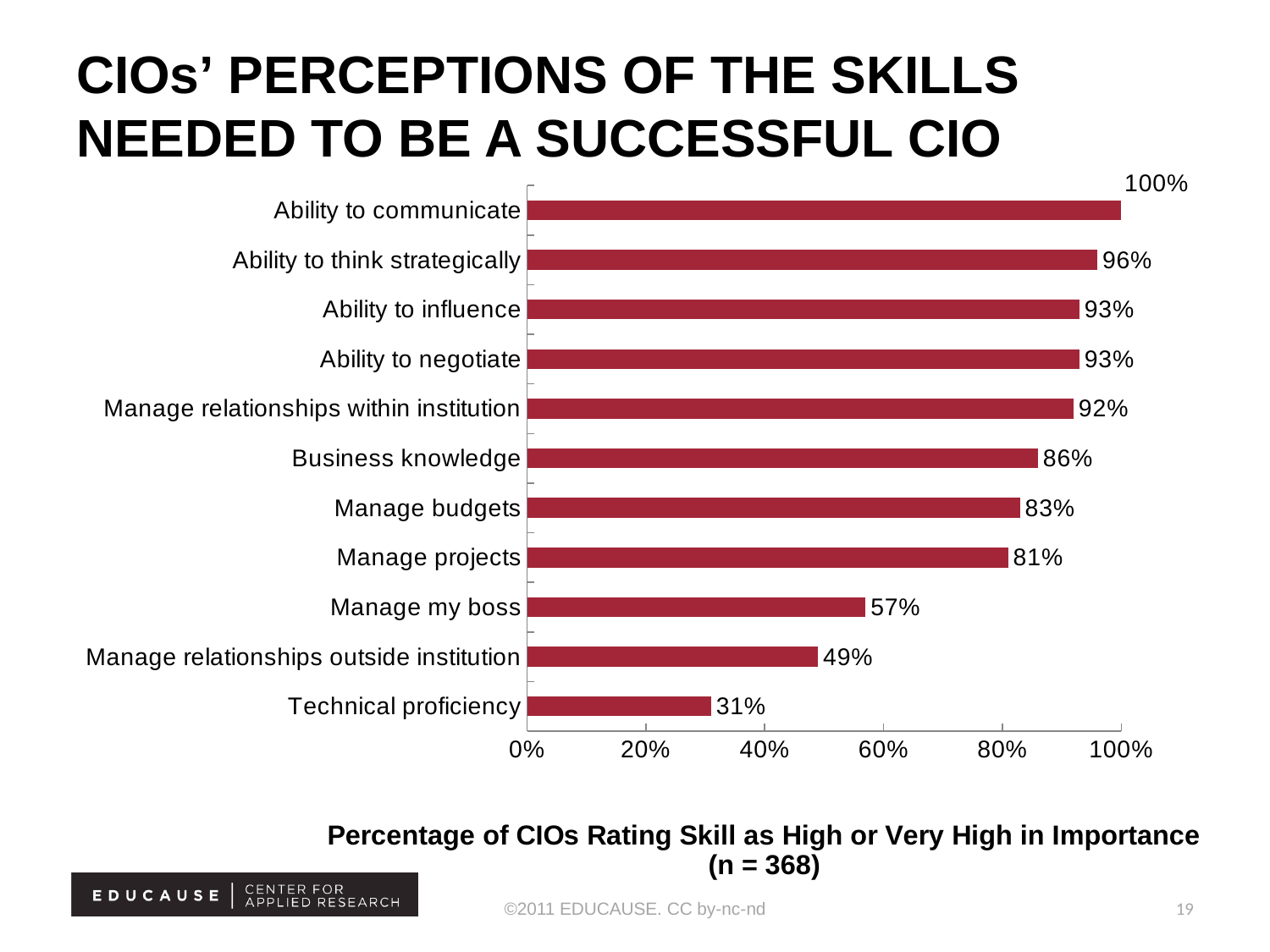
What is the sample size (n) stated below the chart? 368 Is the value for 'Manage relationships outside institution' greater or less than 60%? less Which skill has the lowest percentage? Technical proficiency What kind of chart is shown on the slide? Bar chart What is the value for 'Manage my boss'? 57% Which skill has the highest percentage? Ability to communicate How many skills are shown in the chart? 11 What is the value for 'Business knowledge'? 86% What is the value for 'Technical proficiency'? 31% What is the difference between 'Ability to think strategically' and 'Manage projects'? 15% Which is larger: 'Manage budgets' or 'Manage relationships outside institution'? Manage budgets What percentage of CIOs rated 'Ability to communicate' as high or very high in importance? 100%